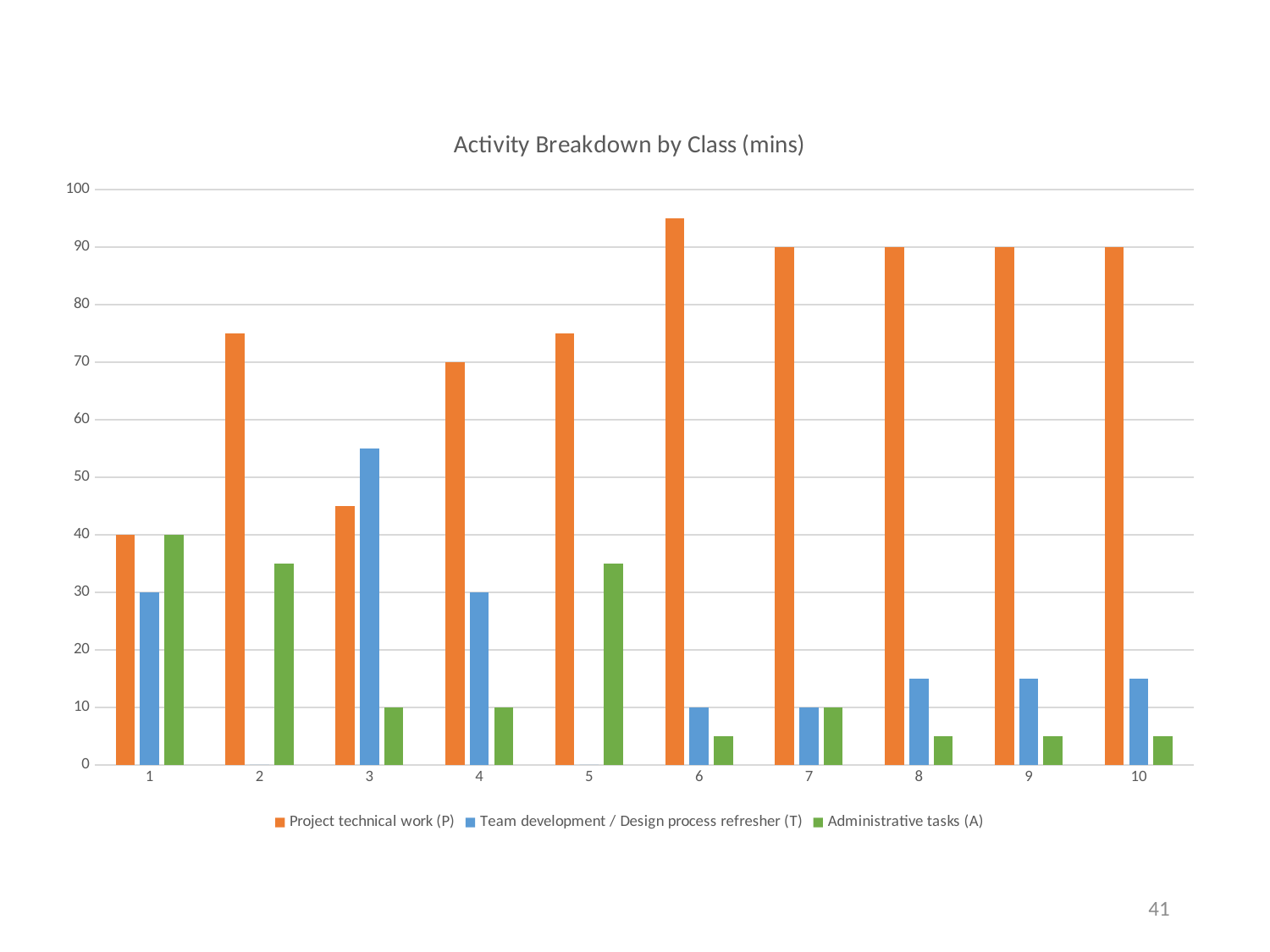
For which class is Team development / Design process refresher (T) highest? 3 How many series does the legend list? 3 What is the value of Team development / Design process refresher (T) for class 1? 30 What is the title of the chart? Activity Breakdown by Class (mins) For class 3, which is larger: Project technical work (P) or Team development / Design process refresher (T)? Team development / Design process refresher (T) What is the difference between Project technical work (P) for class 4 and for class 1? 30 How many classes are shown on the x axis? 10 What is the value of Project technical work (P) for class 4? 70 What type of chart is shown on the slide? Bar chart What is the value of Project technical work (P) for class 1? 40 Is the value of Project technical work (P) for class 6 greater or less than 90? greater For which class is Project technical work (P) highest? 6